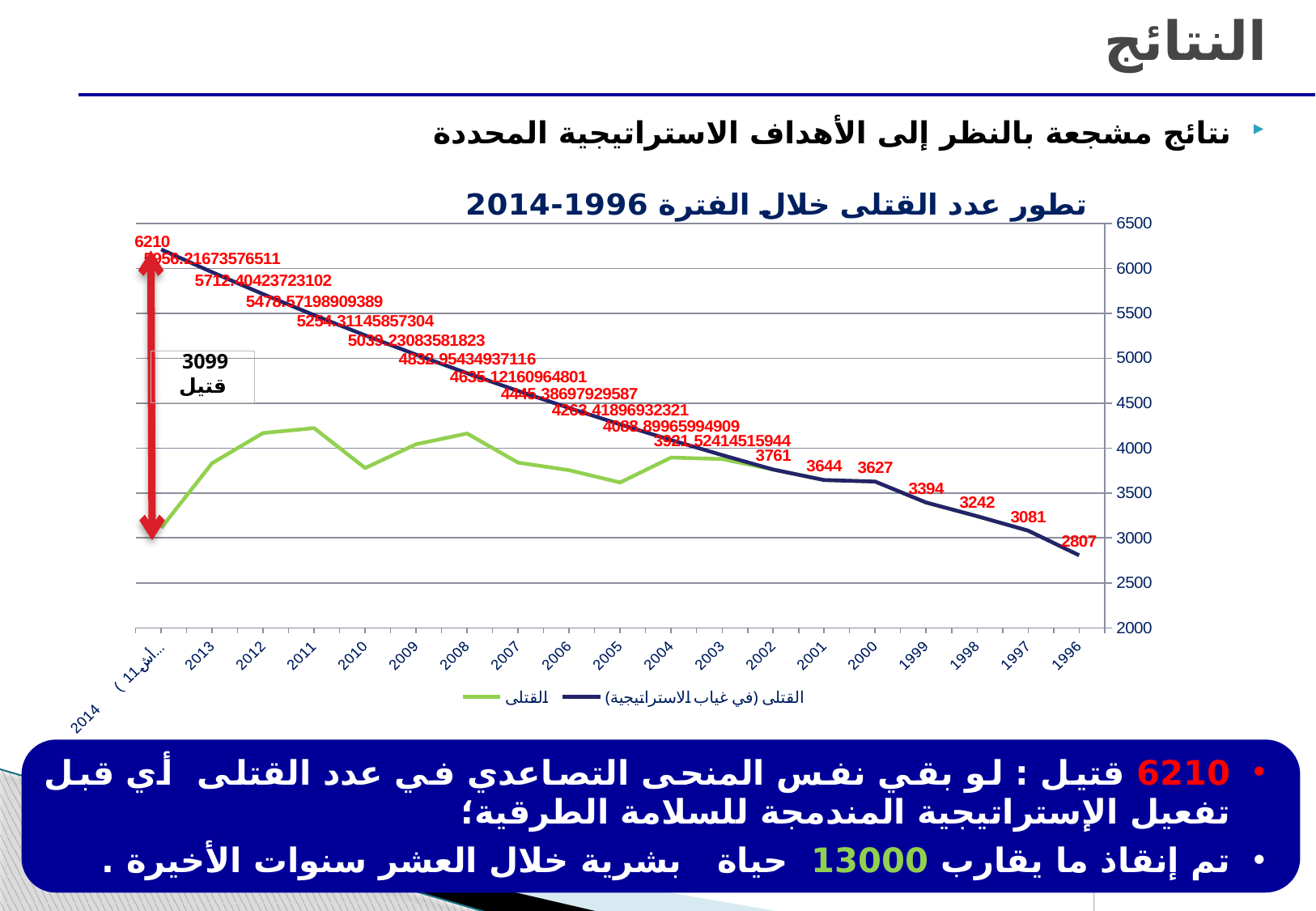
What is the value of the dark line (القتلى في غياب الاستراتيجية) for 1996? 2807 How many series does the chart legend list? 2 What type of chart is shown on the slide? line chart In which year does the dark line (القتلى في غياب الاستراتيجية) reach its highest value? 2014 Is the value of the green line (القتلى) for 2011 greater or less than 4000? greater Does the dark line (القتلى في غياب الاستراتيجية) rise or fall from 1996 to 2014? rises What is the difference between the dark line values for 1997 and 1996? 274 In which year does the dark line (القتلى في غياب الاستراتيجية) reach its lowest value? 1996 Which is larger on the dark line: the value for 2000 or the value for 1999? 2000 What is the value of the dark line (القتلى في غياب الاستراتيجية) for 2002? 3761 What is the value of the dark line (القتلى في غياب الاستراتيجية) for 2014? 6210 What is the title of the chart? تطور عدد القتلى خلال الفترة 1996-2014